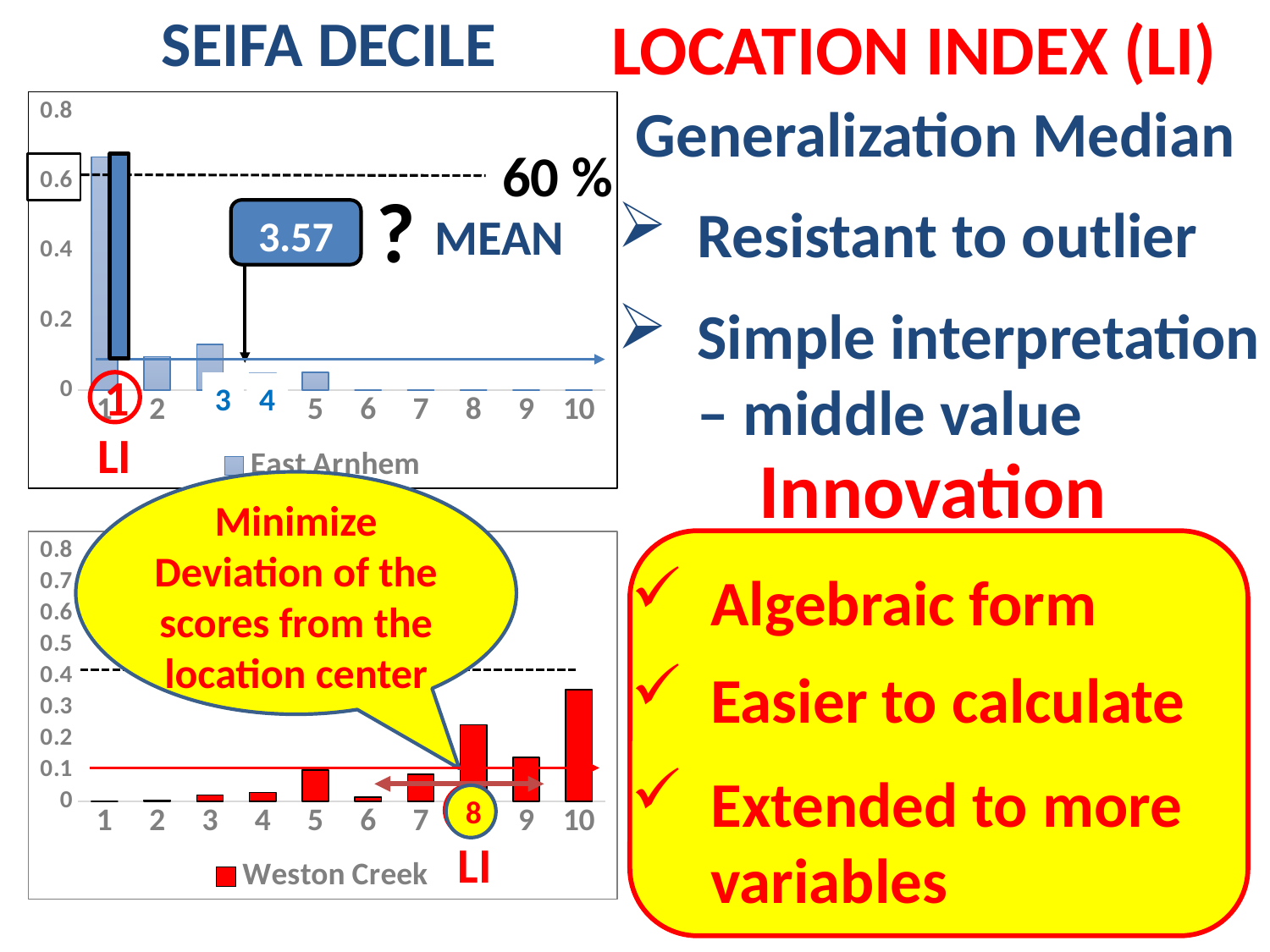
How many series does the legend of the bottom chart list? 1 In the bottom chart (Weston Creek), is the value for decile 8 greater or less than 0.2? greater In the top chart (East Arnhem), which SEIFA decile has the highest value? 1 What type of chart is the top chart (East Arnhem)? bar chart What mean value is labelled in the top chart (East Arnhem)? 3.57 How many SEIFA deciles are shown on the x axis of the top chart (East Arnhem)? 10 In the top chart (East Arnhem), is the value for decile 3 greater or less than 0.2? less In the bottom chart (Weston Creek), which is larger, the value for decile 8 or decile 9? decile 8 In the top chart (East Arnhem), is the value for decile 1 greater or less than 0.6? greater In the bottom chart (Weston Creek), which SEIFA decile has the highest value? 10